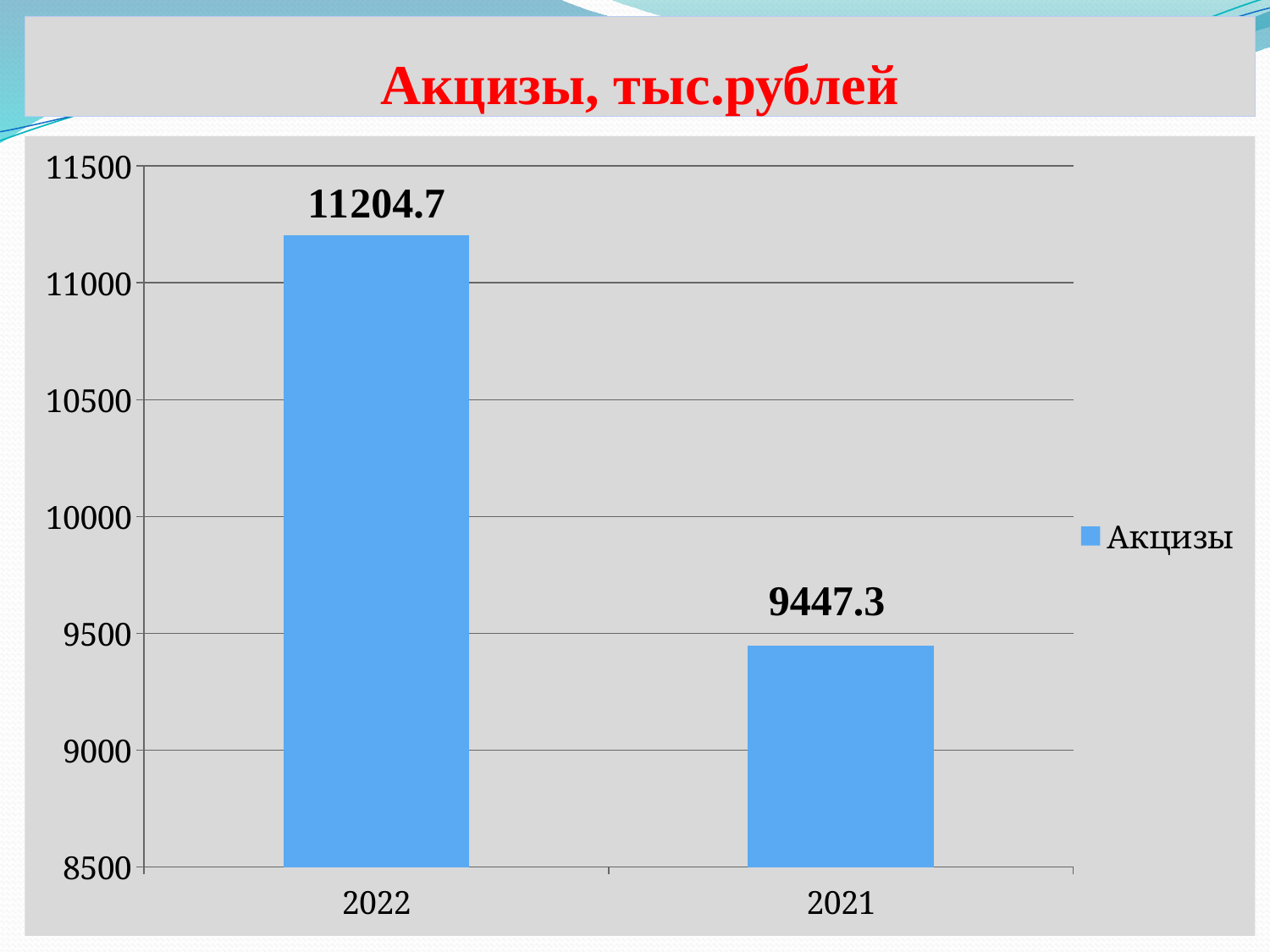
Which is larger, the value for 2022 or the value for 2021? 2022 What kind of chart is shown? bar chart What is the title of the chart? Акцизы, тыс.рублей How many categories are shown on the x axis? 2 Which year has the lowest value? 2021 What is the value for 2021? 9447.3 What is the difference between the values for 2022 and 2021? 1757.4 Which year has the highest value? 2022 Is the value for 2021 greater or less than 9500? less Is the value for 2022 greater or less than 11000? greater What is the value for 2022? 11204.7 How many series does the legend list? 1